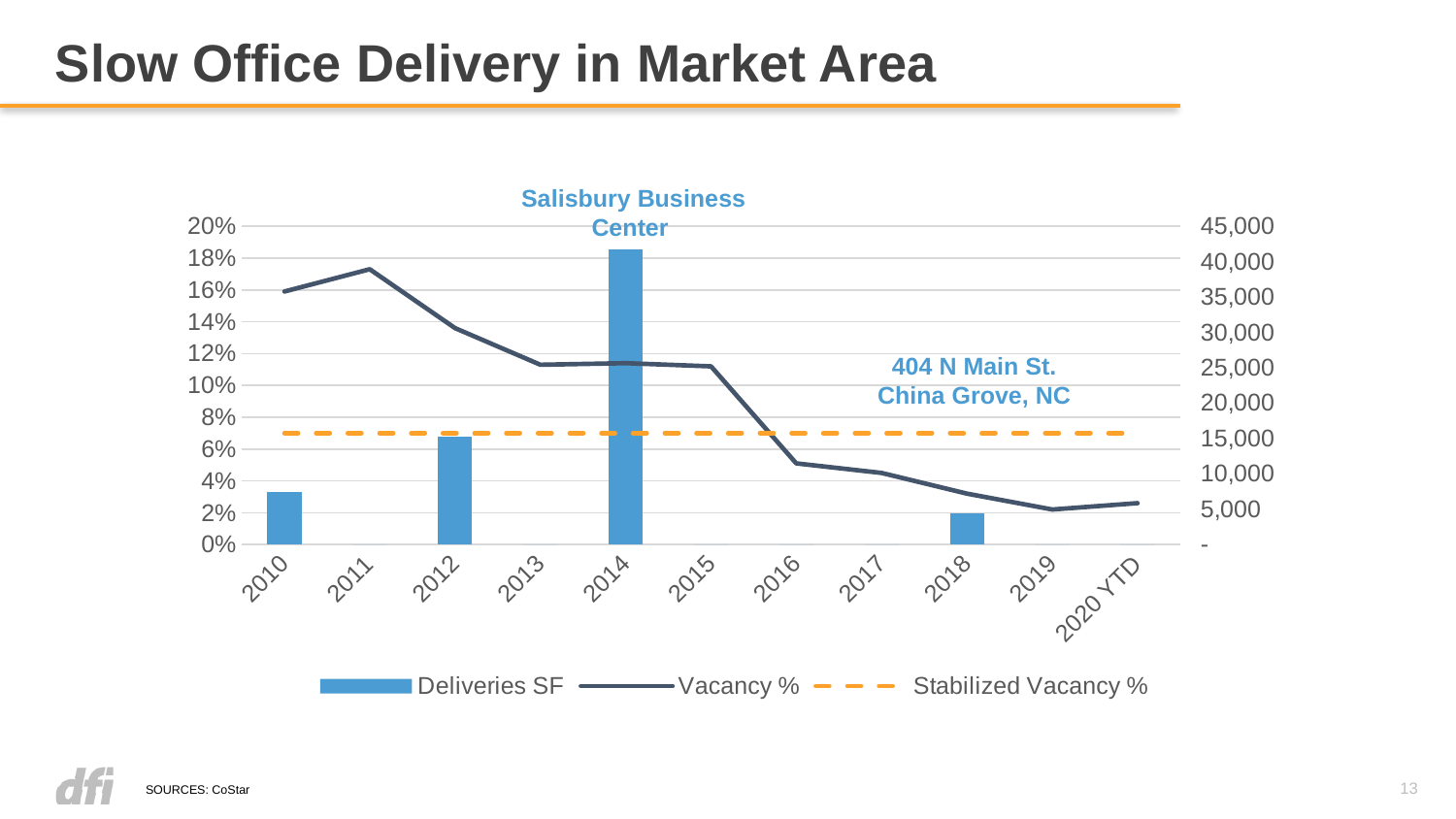
In which year is the Deliveries SF bar the highest? 2014 Is the Deliveries SF value for 2010 greater or less than 10,000? less Is the Deliveries SF value for 2014 greater or less than 40,000? greater Which series is drawn as an orange dashed line? Stabilized Vacancy % Which year has the smallest Deliveries SF bar among the years with a bar? 2018 What kind of chart is shown on the slide? A combination bar and line chart Is the Vacancy % value for 2019 greater or less than 4%? less How many years (categories) are shown on the x axis? 11 Does the Vacancy % line generally rise or fall from 2011 to 2019? fall How many series does the legend list? 3 Is the Vacancy % higher in 2011 or in 2017? 2011